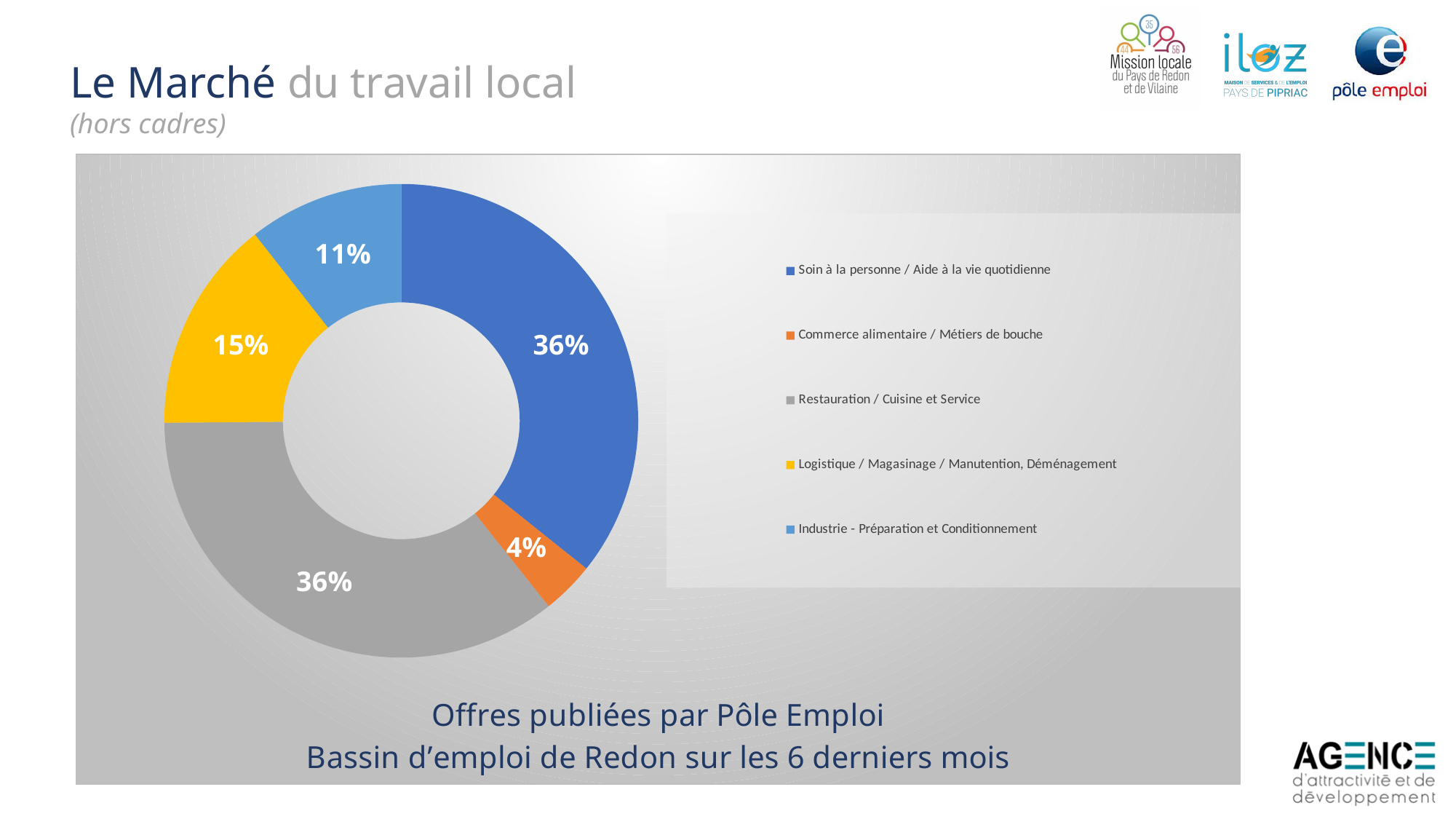
Which has the larger share: Logistique / Magasinage / Manutention, Déménagement or Industrie - Préparation et Conditionnement? Logistique / Magasinage / Manutention, Déménagement How many categories are shown in the chart? 5 What kind of chart is shown on the slide? Doughnut (pie) chart What share of the offers is for Soin à la personne / Aide à la vie quotidienne? 36% What is the difference in percentage points between the Logistique / Magasinage / Manutention, Déménagement share and the Industrie - Préparation et Conditionnement share? 4 percentage points What share of the offers is for Industrie - Préparation et Conditionnement? 11% What share of the offers is for Commerce alimentaire / Métiers de bouche? 4% What share of the offers is for Restauration / Cuisine et Service? 36% What share of the offers is for Logistique / Magasinage / Manutention, Déménagement? 15% Which category has the smallest share of the offers? Commerce alimentaire / Métiers de bouche What is the caption below the chart? Offres publiées par Pôle Emploi Bassin d'emploi de Redon sur les 6 derniers mois What colour is the slice for Logistique / Magasinage / Manutention, Déménagement? Yellow